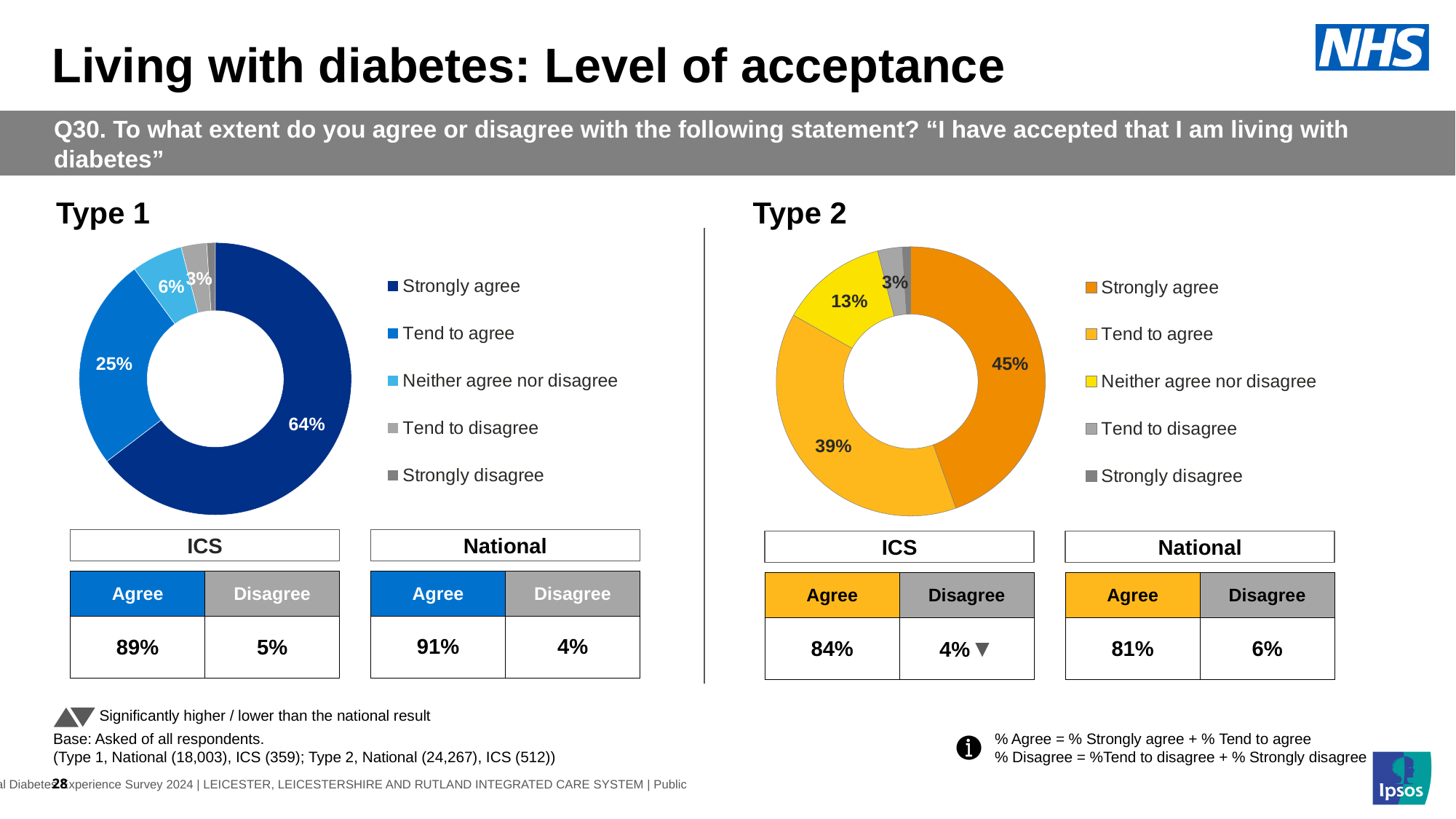
What colour represents Neither agree nor disagree in the Type 2 chart? Yellow In the Type 1 chart, which response category has the largest share? Strongly agree In the Type 1 chart, what percentage of respondents strongly agree? 64% In the Type 1 chart, what percentage tend to disagree? 3% In the Type 2 chart, what is the difference in percentage points between Strongly agree and Tend to agree? 6 How many response categories does the legend of the Type 1 chart list? 5 Which is larger: the Tend to agree share in the Type 1 chart or the Tend to agree share in the Type 2 chart? Type 2 In the Type 2 chart, what percentage neither agree nor disagree? 13% What kind of chart is used for the Type 2 data? Donut (pie) chart In the Type 2 chart, what percentage of respondents tend to agree? 39% In the Type 1 chart, what is the difference in percentage points between Strongly agree and Tend to agree? 39 In the Type 2 chart, which response category has the largest share? Strongly agree